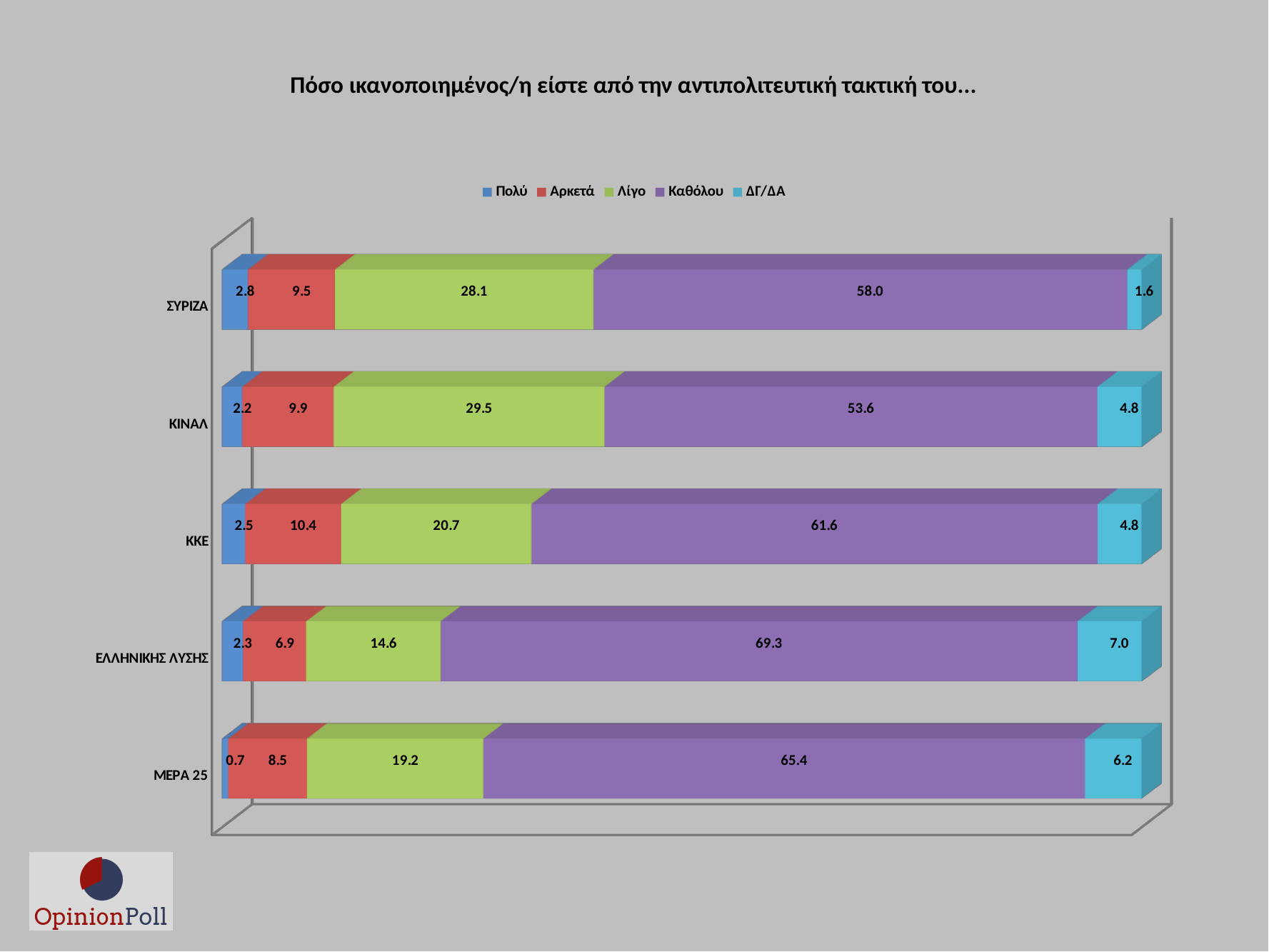
What is the Λίγο value for ΚΙΝΑΛ? 29.5 What is the difference between the Λίγο values for ΚΙΝΑΛ and ΚΚΕ? 8.8 Which party has the highest Καθόλου value? ΕΛΛΗΝΙΚΗΣ ΛΥΣΗΣ Which is larger, the Καθόλου value for ΚΚΕ or for ΜΕΡΑ 25? ΜΕΡΑ 25 Which party has the lowest Πολύ value? ΜΕΡΑ 25 Which colour represents Καθόλου in the legend? Purple What is the Καθόλου value for ΣΥΡΙΖΑ? 58.0 How many parties are shown in the chart? 5 What is the Αρκετά value for ΚΚΕ? 10.4 What kind of chart is shown on the slide? Stacked bar chart How many series does the legend list? 5 What is the ΔΓ/ΔΑ value for ΕΛΛΗΝΙΚΗΣ ΛΥΣΗΣ? 7.0